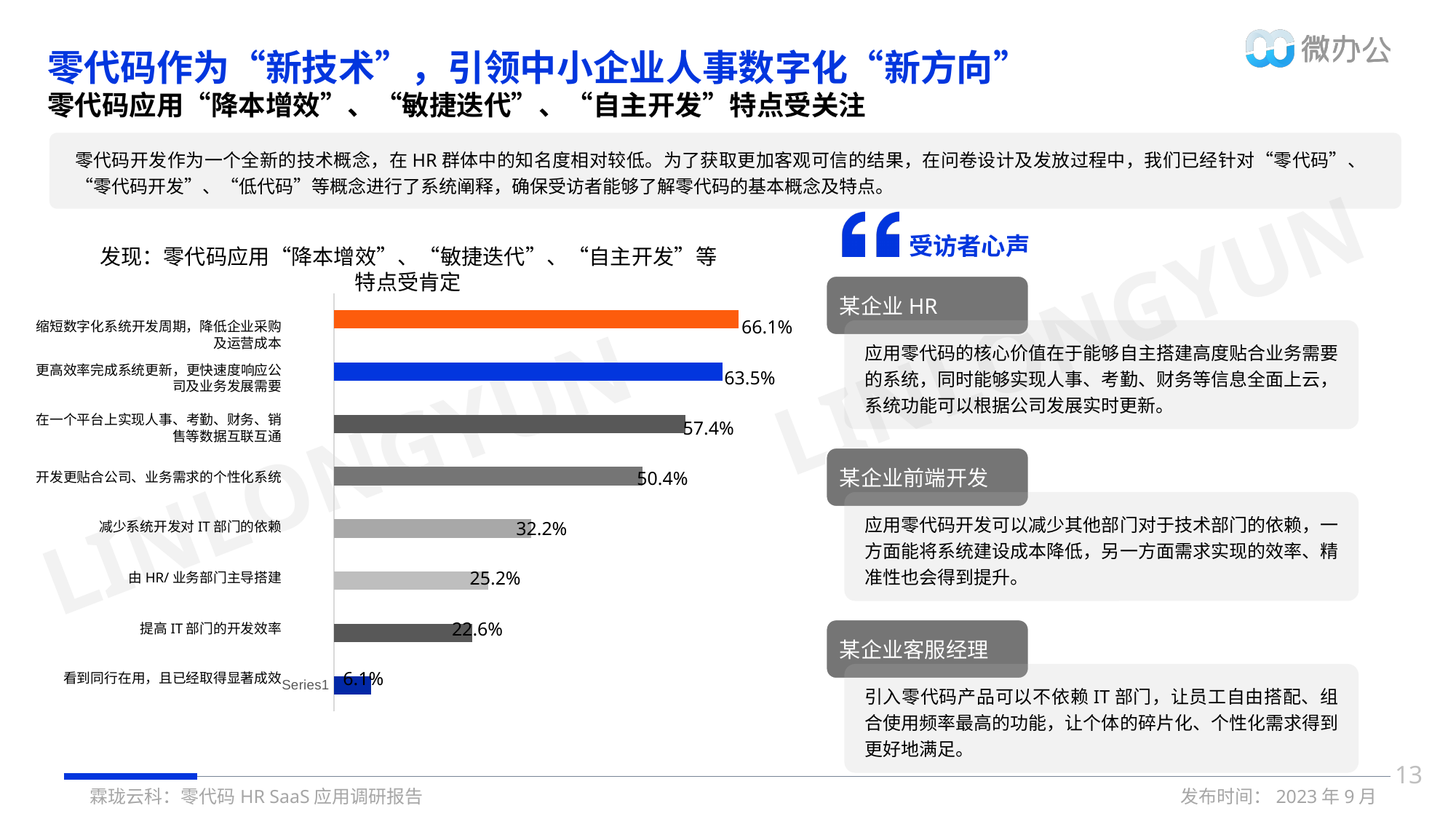
Do the bar values increase or decrease going from the top category to the bottom category? Decrease Which is larger: the value for "在一个平台上实现人事、考勤、财务、销售等数据互联互通" or for "开发更贴合公司、业务需求的个性化系统"? 在一个平台上实现人事、考勤、财务、销售等数据互联互通 What is the value for "提高 IT 部门的开发效率"? 22.6% What type of chart is shown on the slide? Bar chart How many categories are plotted in the bar chart? 8 Which category has the lowest value in the chart? 看到同行在用，且已经取得显著成效 What colour is the bar for "更高效率完成系统更新，更快速度响应公司及业务发展需要"? Blue What is the value for "看到同行在用，且已经取得显著成效"? 6.1% What is the difference between the values for "减少系统开发对 IT 部门的依赖" and "由 HR/ 业务部门主导搭建"? 7.0 percentage points Which category has the highest value in the chart? 缩短数字化系统开发周期，降低企业采购及运营成本 What is the value for "减少系统开发对 IT 部门的依赖"? 32.2% What is the value for "缩短数字化系统开发周期，降低企业采购及运营成本"? 66.1%